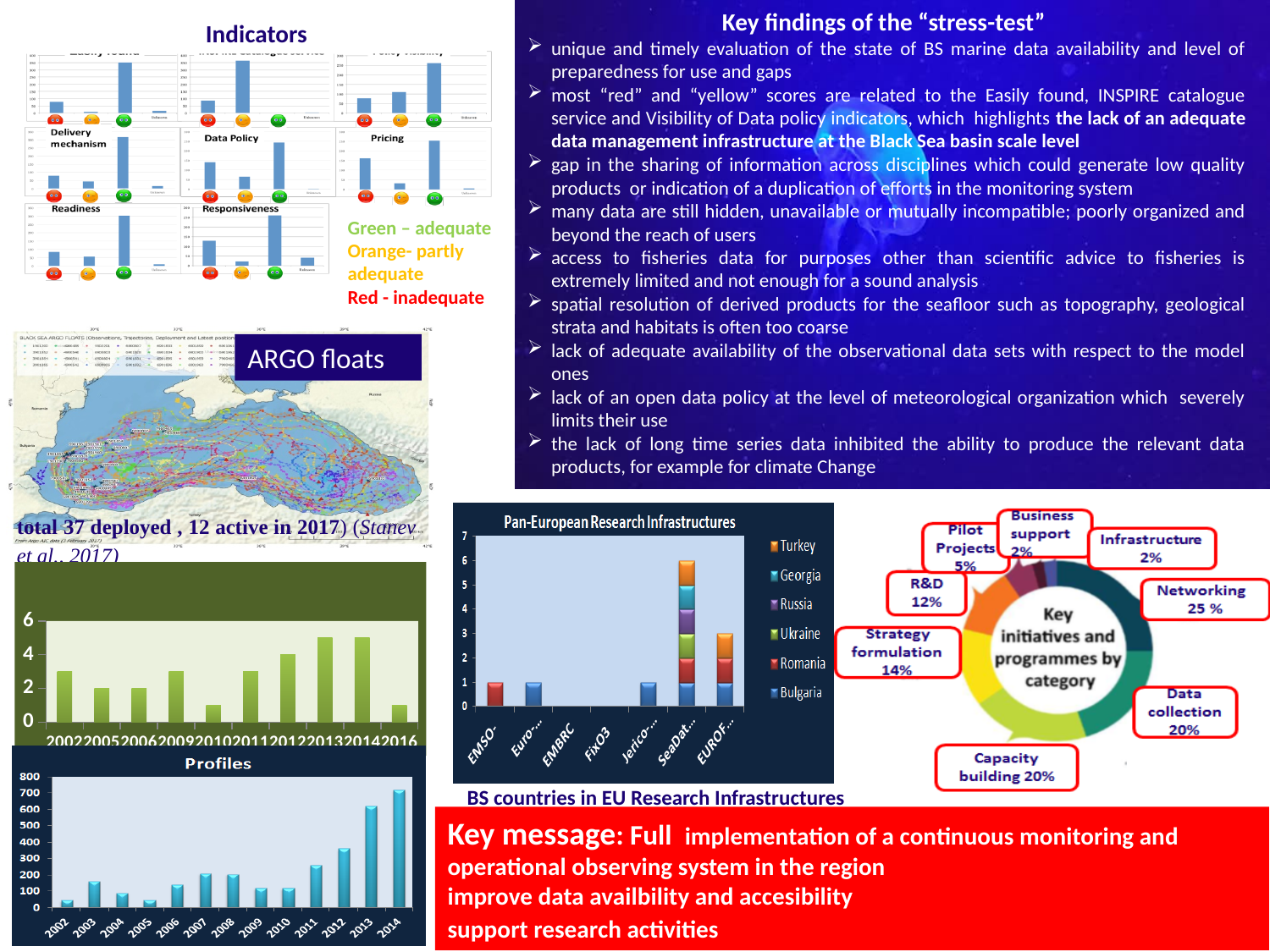
In the pie chart of key initiatives and programmes by category, what share is Networking? 25 % In the pie chart of key initiatives and programmes by category, which category has the largest share? Networking In the Pan-European Research Infrastructures chart, how many countries does the legend list? 6 In the Profiles chart, which year has the highest value? 2014 In the pie chart of key initiatives and programmes by category, how many categories are shown? 8 In the pie chart of key initiatives and programmes by category, what is the difference between the Networking share and the R&D share? 13% In the green bar chart of years above the Profiles chart, is the value for 2013 greater or less than 4? greater What kind of chart is the Pan-European Research Infrastructures chart? Stacked bar chart In the Profiles chart, is the value for 2012 greater or less than 400? less In the Pan-European Research Infrastructures chart, which infrastructure has the tallest stacked bar? SeaDat... In the pie chart of key initiatives and programmes by category, what share is Strategy formulation? 14%